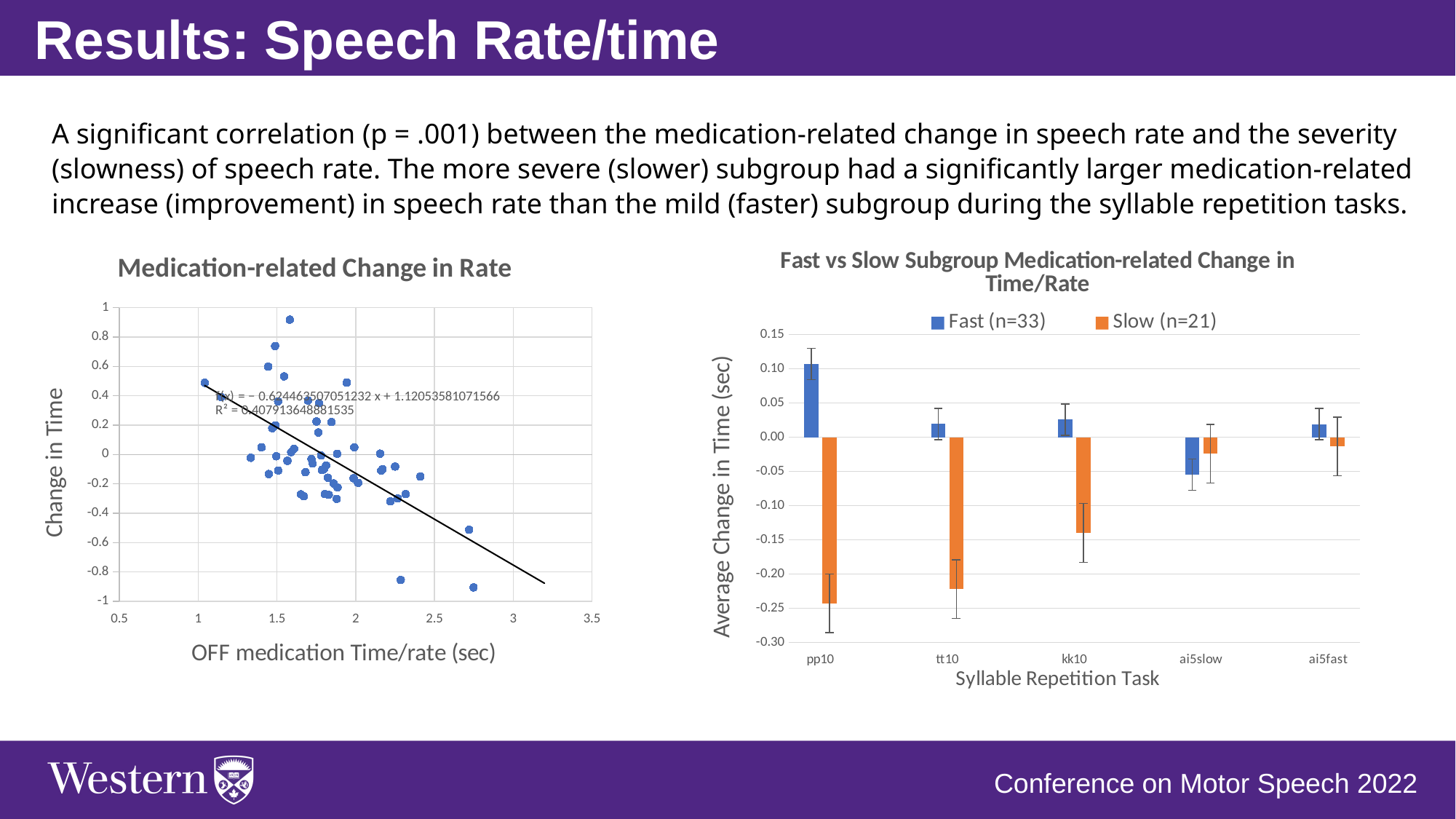
What kind of chart is the 'Fast vs Slow Subgroup Medication-related Change in Time/Rate' chart? bar chart In the 'Medication-related Change in Rate' scatter plot, do the points generally rise or fall as OFF medication Time/rate increases? fall In the 'Fast vs Slow Subgroup' bar chart, is the Slow (n=21) value for kk10 greater or less than -0.10? less In the 'Fast vs Slow Subgroup' bar chart, which task has the highest value for the Fast (n=33) series? pp10 In the 'Fast vs Slow Subgroup' bar chart, is the Slow (n=21) value for pp10 greater or less than -0.20? less In the 'Fast vs Slow Subgroup' bar chart, how many series does the legend list? 2 In the 'Fast vs Slow Subgroup' bar chart, how many syllable repetition tasks are shown on the x axis? 5 In the 'Fast vs Slow Subgroup' bar chart, is the Fast (n=33) value for pp10 greater or less than 0.05? greater In the 'Fast vs Slow Subgroup' bar chart, which is larger for tt10: the Fast (n=33) value or the Slow (n=21) value? Fast (n=33) What kind of chart is the 'Medication-related Change in Rate' chart on the left? scatter plot In the 'Fast vs Slow Subgroup' bar chart, what colour are the Slow (n=21) bars? orange What is the x-axis title of the 'Medication-related Change in Rate' scatter plot? OFF medication Time/rate (sec)